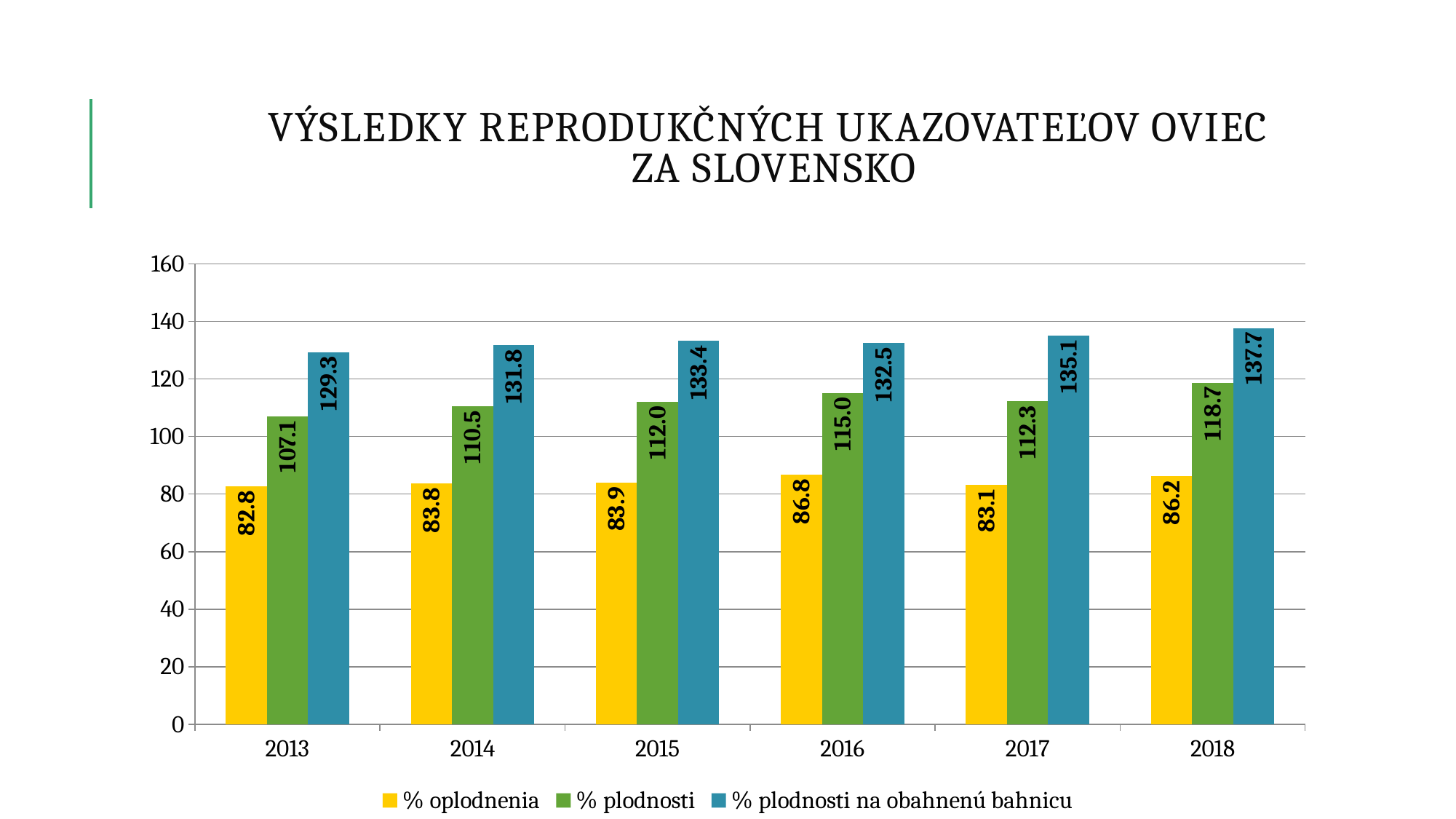
What is the difference between the % plodnosti values for 2018 and 2013? 11.6 What is the value of % oplodnenia for 2016? 86.8 What is the value of % plodnosti for 2014? 110.5 How many years are shown on the x axis? 6 Which is larger: % plodnosti for 2016 or % plodnosti for 2017? % plodnosti for 2016 Is the value of % plodnosti na obahnenú bahnicu for 2013 greater or less than 120? greater Which year has the lowest value for % oplodnenia? 2013 What kind of chart is shown on the slide? bar chart What is the value of % plodnosti na obahnenú bahnicu for 2018? 137.7 Which year has the highest value for % plodnosti na obahnenú bahnicu? 2018 How many series does the legend list? 3 Does the % plodnosti na obahnenú bahnicu series rise or fall from 2013 to 2018? rise